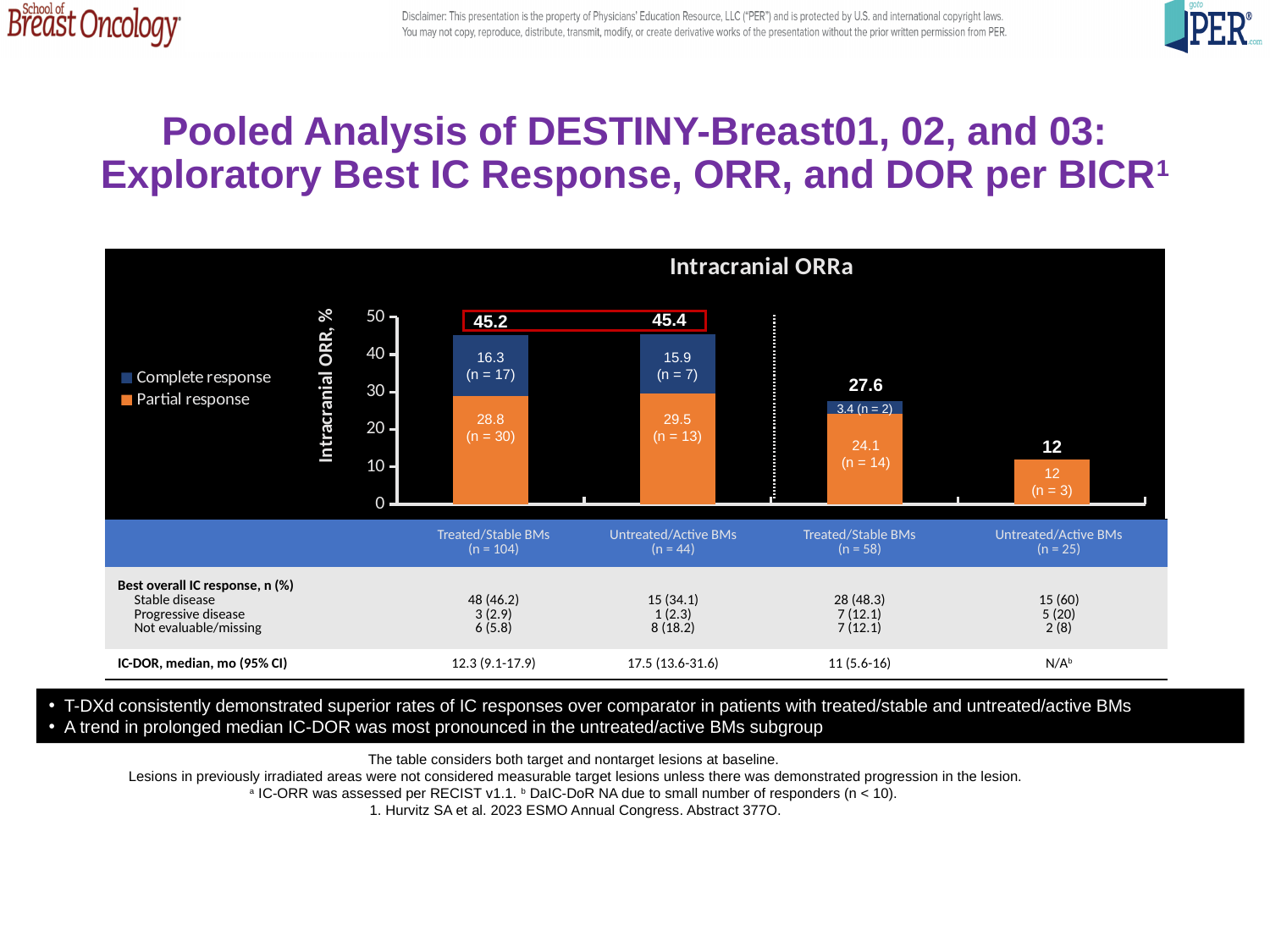
In the Intracranial ORR chart, what is the partial response value for Treated/Stable BMs (n = 104)? 28.8 In the Intracranial ORR chart, what is the total intracranial ORR shown above the Treated/Stable BMs (n = 58) bar? 27.6 How many series does the legend of the Intracranial ORR chart list? 2 In the Intracranial ORR chart, what is the total intracranial ORR shown above the Untreated/Active BMs (n = 44) bar? 45.4 What is the title of the chart on the slide? Intracranial ORRa What kind of chart is the Intracranial ORR chart? Stacked bar chart In the Intracranial ORR chart, which group has the lowest total intracranial ORR? Untreated/Active BMs (n = 25) In the Intracranial ORR chart, is the total ORR for Untreated/Active BMs (n = 25) greater or less than 20? less How many bars are plotted in the Intracranial ORR chart? 4 In the Intracranial ORR chart, what is the complete response value for Treated/Stable BMs (n = 58)? 3.4 In the Intracranial ORR chart, what is the difference in partial response between Treated/Stable BMs (n = 104) and Treated/Stable BMs (n = 58)? 4.7 In the Intracranial ORR chart, what is the complete response value for Untreated/Active BMs (n = 44)? 15.9